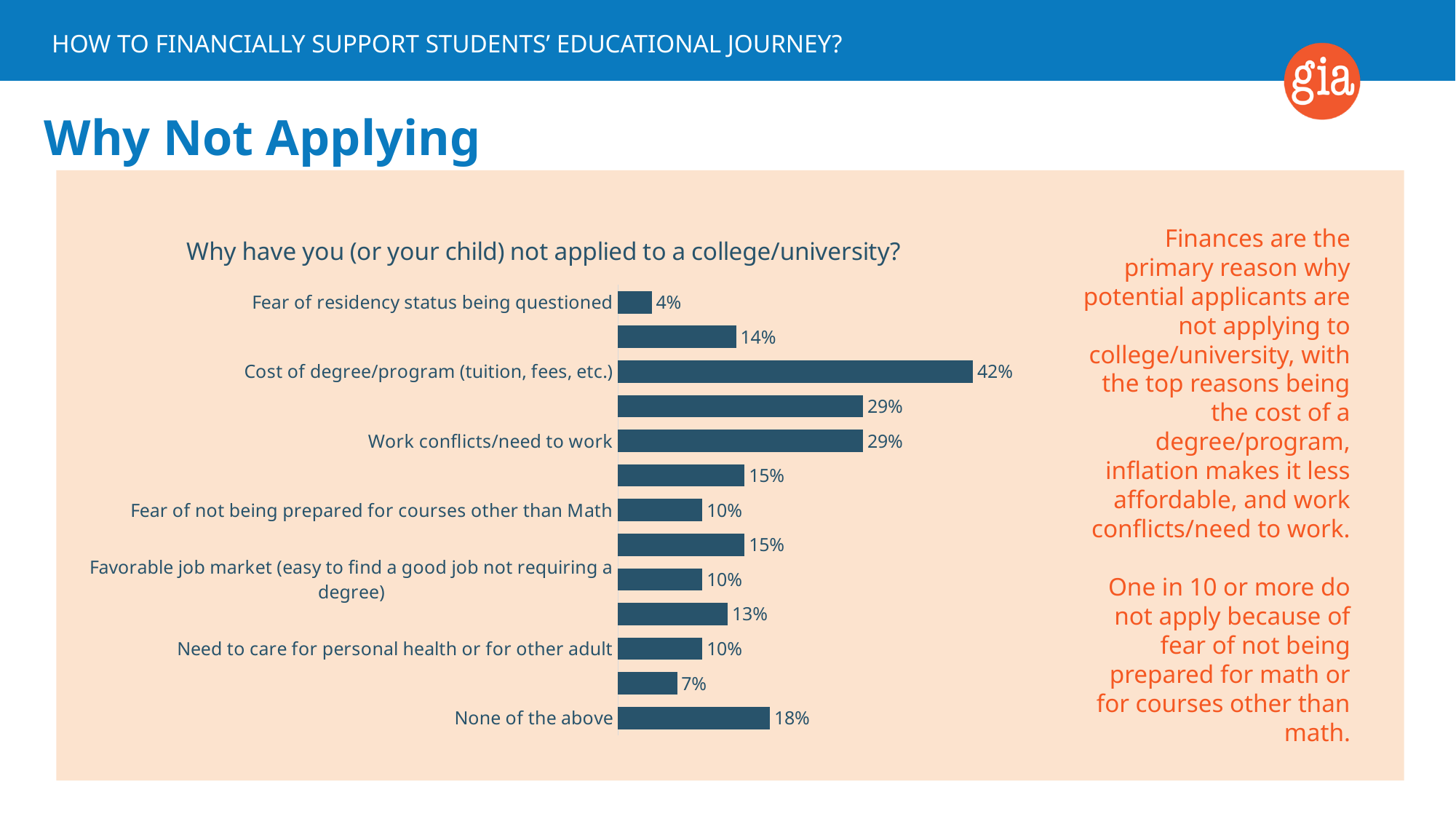
What is the difference in percentage points between "Cost of degree/program (tuition, fees, etc.)" and "Work conflicts/need to work"? 13 What percentage is shown for "Work conflicts/need to work"? 29% Which is larger: the value for "Work conflicts/need to work" or the value for "None of the above"? Work conflicts/need to work What type of chart is shown on the slide? Bar chart Which reason has the lowest percentage in the chart? Fear of residency status being questioned Which reason has the highest percentage in the chart? Cost of degree/program (tuition, fees, etc.) What is the title of the chart? Why have you (or your child) not applied to a college/university? What percentage is shown for "None of the above"? 18% What percentage is shown for "Need to care for personal health or for other adult"? 10% How many bars are plotted in the chart? 13 What percentage is shown for "Cost of degree/program (tuition, fees, etc.)"? 42% What percentage is shown for "Fear of residency status being questioned"? 4%